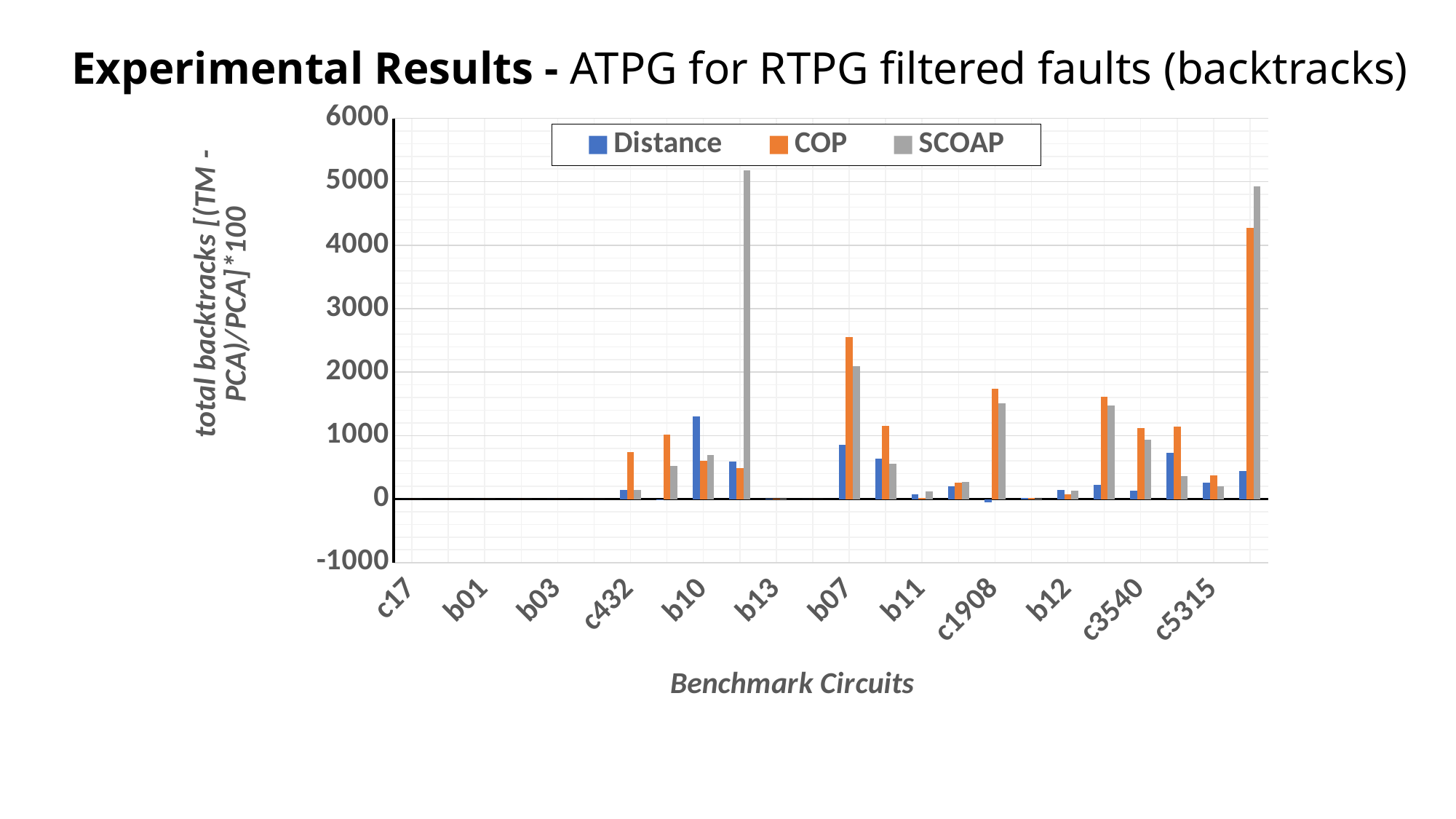
What kind of chart is shown on the slide? bar chart What is the lowest value shown on the y axis? -1000 Is the tallest Distance bar greater or less than 2000? less How many benchmark circuit labels are shown on the x axis? 12 Is the tallest COP bar greater or less than 4000? greater Is the tallest SCOAP bar greater or less than 5000? greater How many series does the legend list? 3 What are the series names listed in the legend? Distance, COP, SCOAP Which series has the tallest bar anywhere on the chart? SCOAP Which series has the tallest bar: COP or Distance? COP What is the title of the x axis? Benchmark Circuits What is the highest value shown on the y axis? 6000